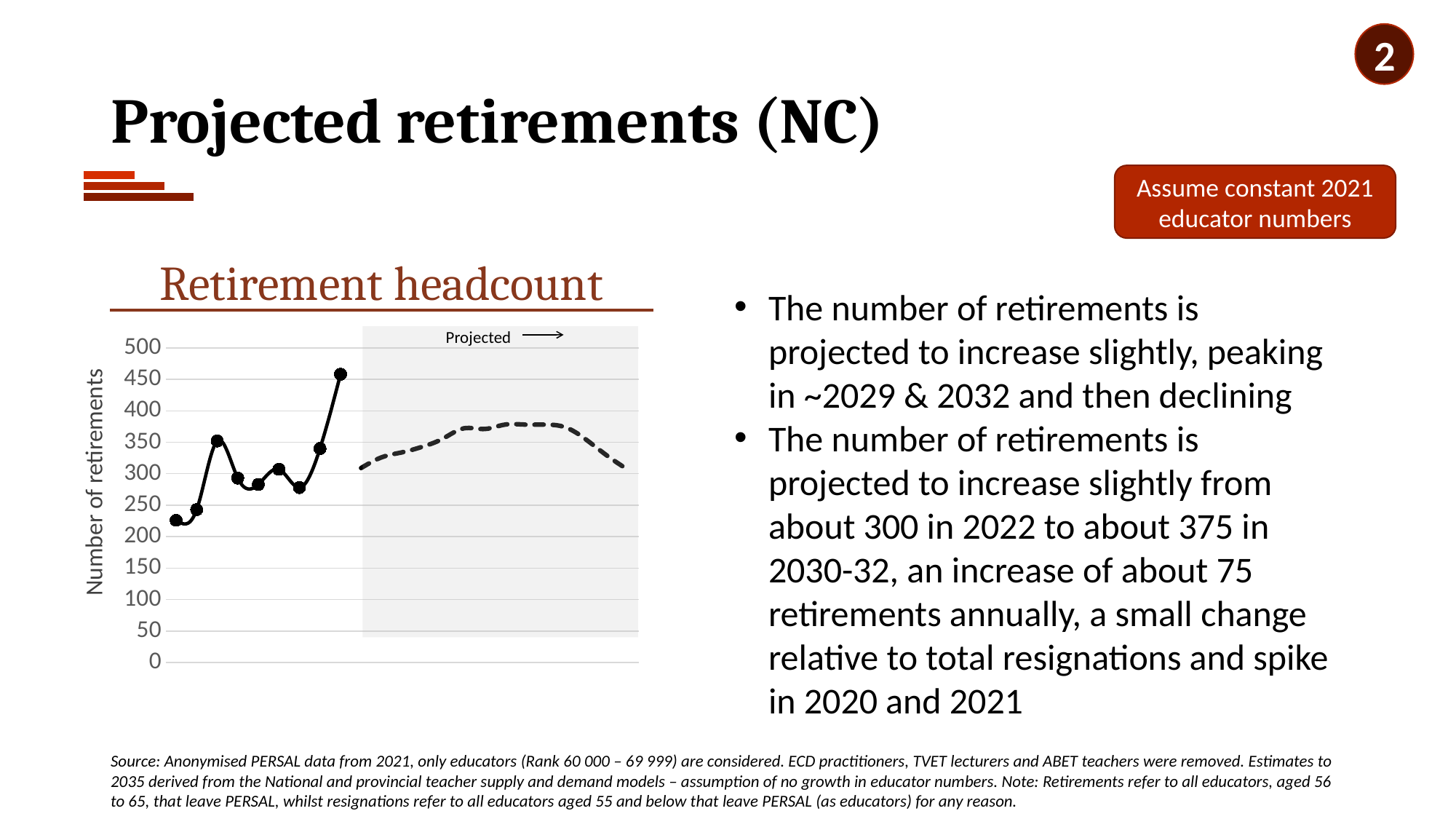
What is the label on the vertical axis of the Retirement headcount chart? Number of retirements Overall, does the solid line in the Retirement headcount chart end higher or lower than it starts? higher Is the first point of the solid line in the Retirement headcount chart greater or less than 250? less Is the lowest point on the solid line of the Retirement headcount chart greater or less than 250? less What kind of chart is the Retirement headcount chart? line chart How many marked data points are on the solid (historical) line of the Retirement headcount chart? 9 Does the dashed projected line in the Retirement headcount chart rise or fall toward its right-hand end? fall Is the highest point on the solid line of the Retirement headcount chart greater or less than 400? greater What is the title of the chart on the slide? Retirement headcount